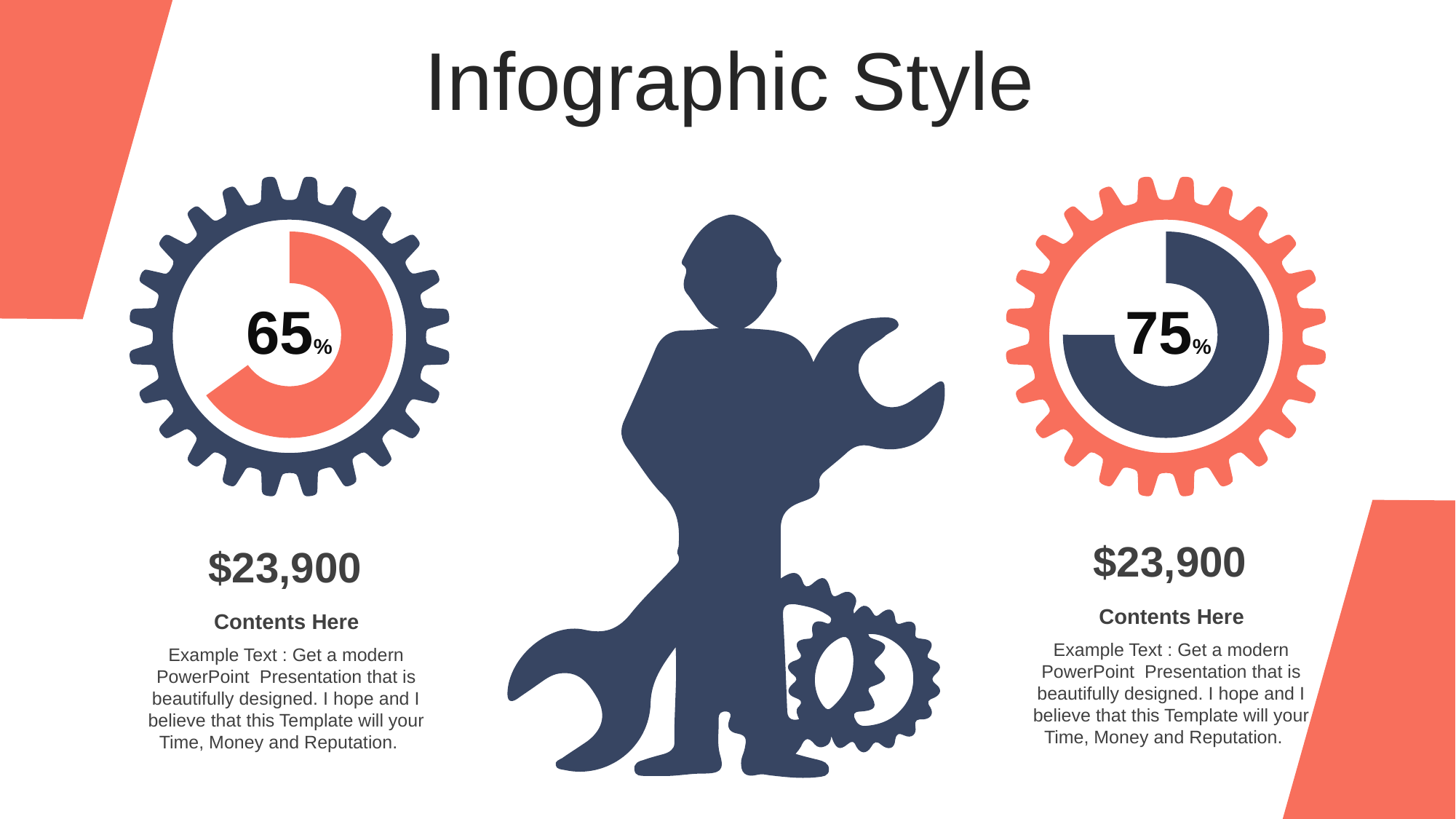
Which of the two gear charts shows the higher percentage, the left or the right? the right Which gear chart shows the lower percentage, the left or the right? the left What is the difference in percentage points between the right gear chart (75%) and the left gear chart (65%)? 10 What percentage is shown in the left gear chart? 65% How many gear-shaped percentage charts are on the slide? 2 What dollar amount is printed below the left gear chart? $23,900 What kind of chart is used to show the 65% and 75% values? doughnut (ring) chart Is the value shown in the left gear chart greater or less than 50%? greater What percentage is shown in the right gear chart? 75% What colour is the filled 65% arc in the left gear chart? orange (coral) Is the value shown in the right gear chart greater or less than 80%? less What colour is the filled 75% arc in the right gear chart? dark navy blue